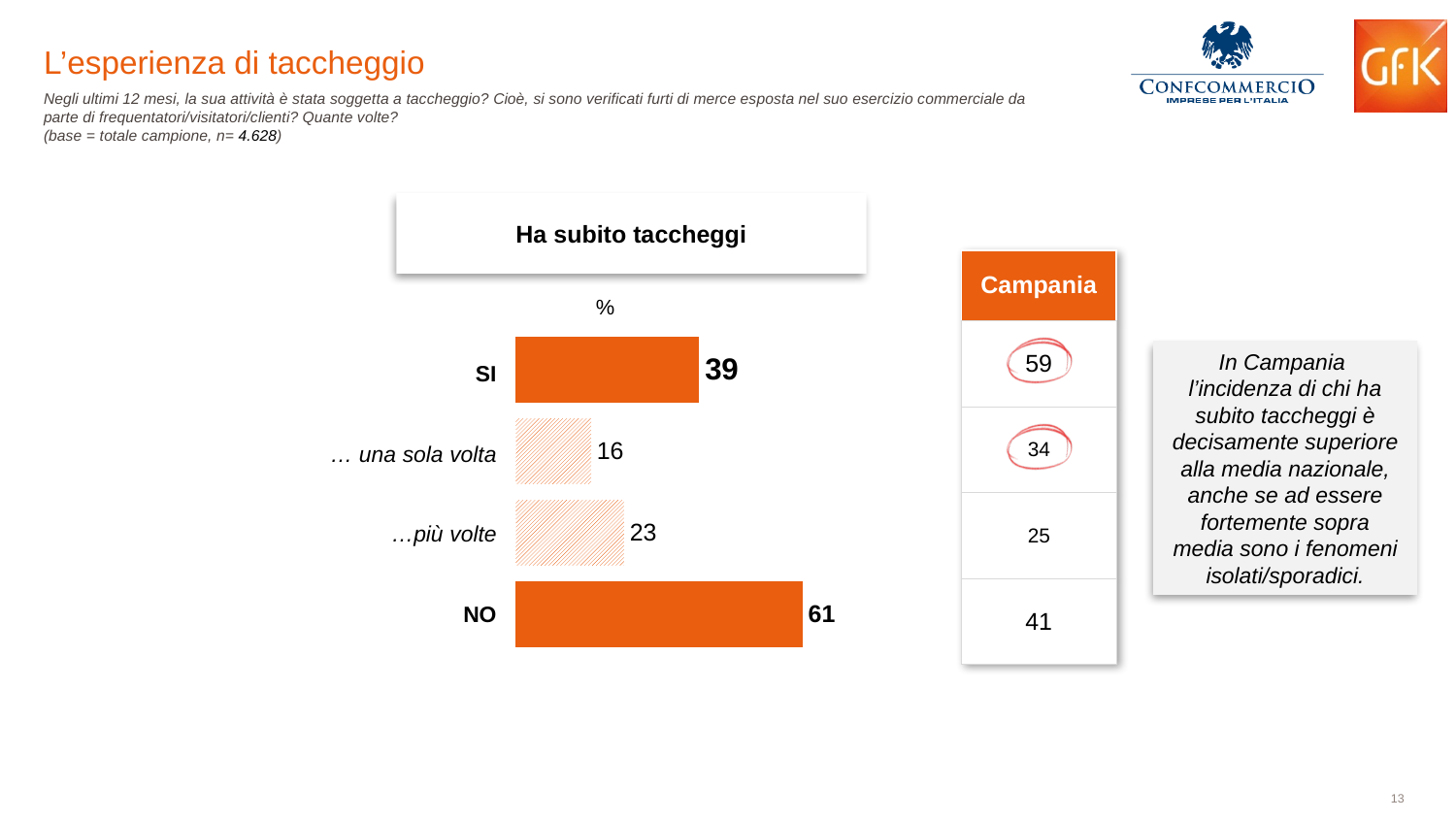
What is the value for NO in the 'Ha subito taccheggi' chart? 61 What is the value for SI in the 'Ha subito taccheggi' chart? 39 Which category has the highest value in the 'Ha subito taccheggi' chart? NO What is the value for '… una sola volta' in the 'Ha subito taccheggi' chart? 16 What is the difference between the values for NO and SI in the 'Ha subito taccheggi' chart? 22 What kind of chart is 'Ha subito taccheggi'? Bar chart What is the title of the chart on the slide? Ha subito taccheggi In the Campania column next to the chart, what is the value for SI? 59 What is the value for '…più volte' in the 'Ha subito taccheggi' chart? 23 In the 'Ha subito taccheggi' chart, which is larger: '…più volte' or '… una sola volta'? …più volte Which category has the lowest value in the 'Ha subito taccheggi' chart? … una sola volta How many categories are shown in the 'Ha subito taccheggi' chart? 4